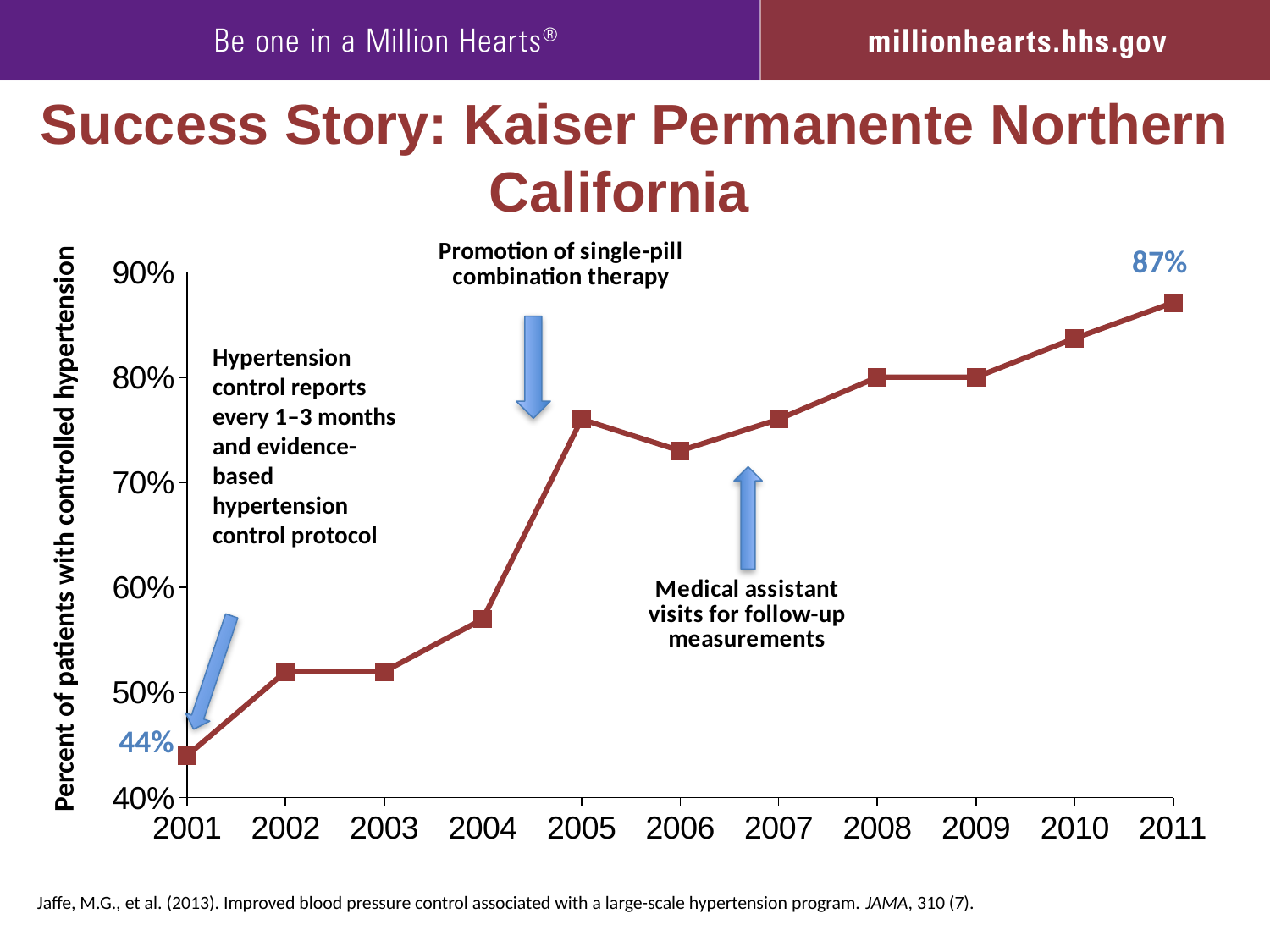
Which is larger, the value for 2005 or the value for 2006? 2005 Is the value for 2005 greater or less than 70%? greater What is the label on the y axis? Percent of patients with controlled hypertension Is the value for 2004 greater or less than 60%? less Do the values generally rise or fall from 2001 to 2011? Rise How many years are plotted on the x axis? 11 What is the difference between the values for 2011 and 2001? 43 percentage points What is the value for 2001? 44% Which year has the highest value? 2011 What is the value for 2011? 87% Which year has the lowest value? 2001 What kind of chart is shown on the slide? Line chart